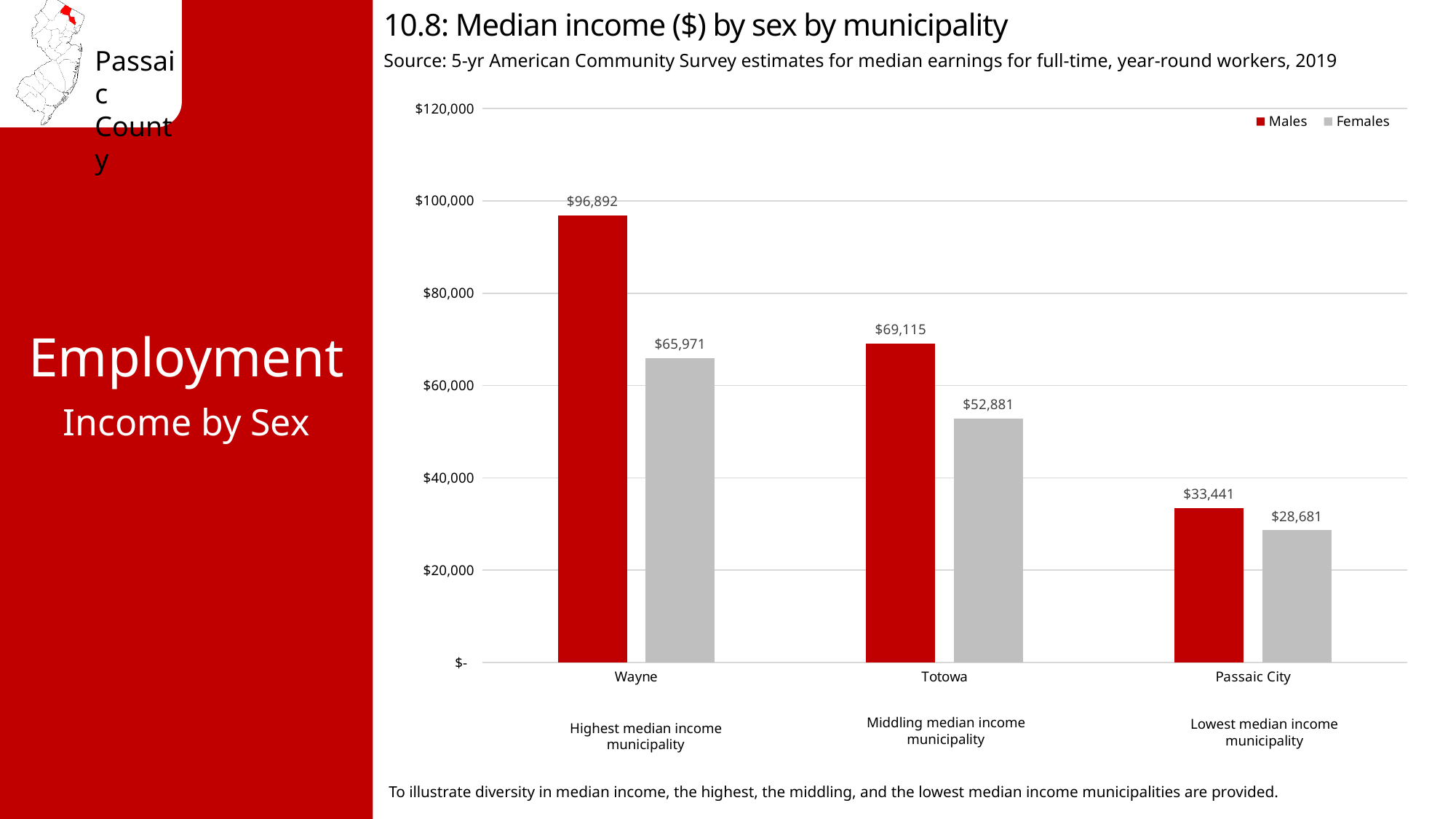
What is the median income for females in Passaic City? $28,681 How many municipalities are shown on the chart? 3 What is the median income for males in Wayne? $96,892 Which municipality has the lowest median income for females? Passaic City Which is larger: female median income in Wayne or male median income in Totowa? Male median income in Totowa Is the male median income in Totowa greater or less than $60,000? greater What is the median income for females in Totowa? $52,881 What is the difference between male and female median income in Wayne? $30,921 Which municipality has the highest median income for males? Wayne What is the difference between male and female median income in Passaic City? $4,760 How many series does the legend list? 2 What type of chart is shown on the slide? Bar chart